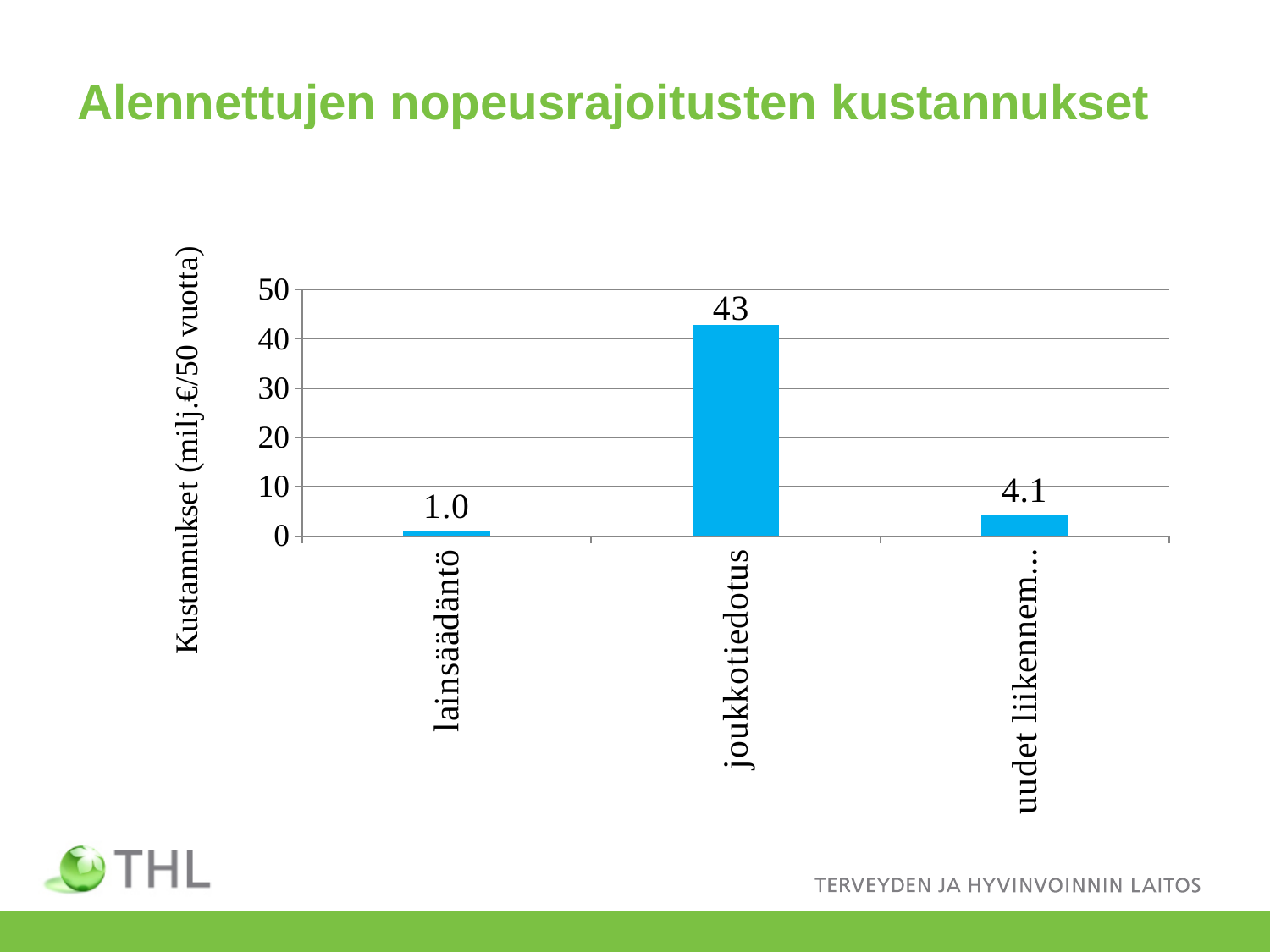
How many categories are shown in the chart? 3 Which is larger: the value for lainsäädäntö or the value of the rightmost bar ("uudet liikennem...")? uudet liikennem... What is the label of the vertical axis? Kustannukset (milj.€/50 vuotta) What is the difference between the value of the rightmost bar ("uudet liikennem...") and lainsäädäntö? 3.1 What kind of chart is shown on the slide? bar chart What is the value for joukkotiedotus? 43 What is the value of the rightmost bar, labelled "uudet liikennem..."? 4.1 What is the difference between the values for joukkotiedotus and lainsäädäntö? 42 Which category has the lowest value? lainsäädäntö Is the value for joukkotiedotus greater or less than 40? greater Which category has the highest value? joukkotiedotus What is the value for lainsäädäntö? 1.0